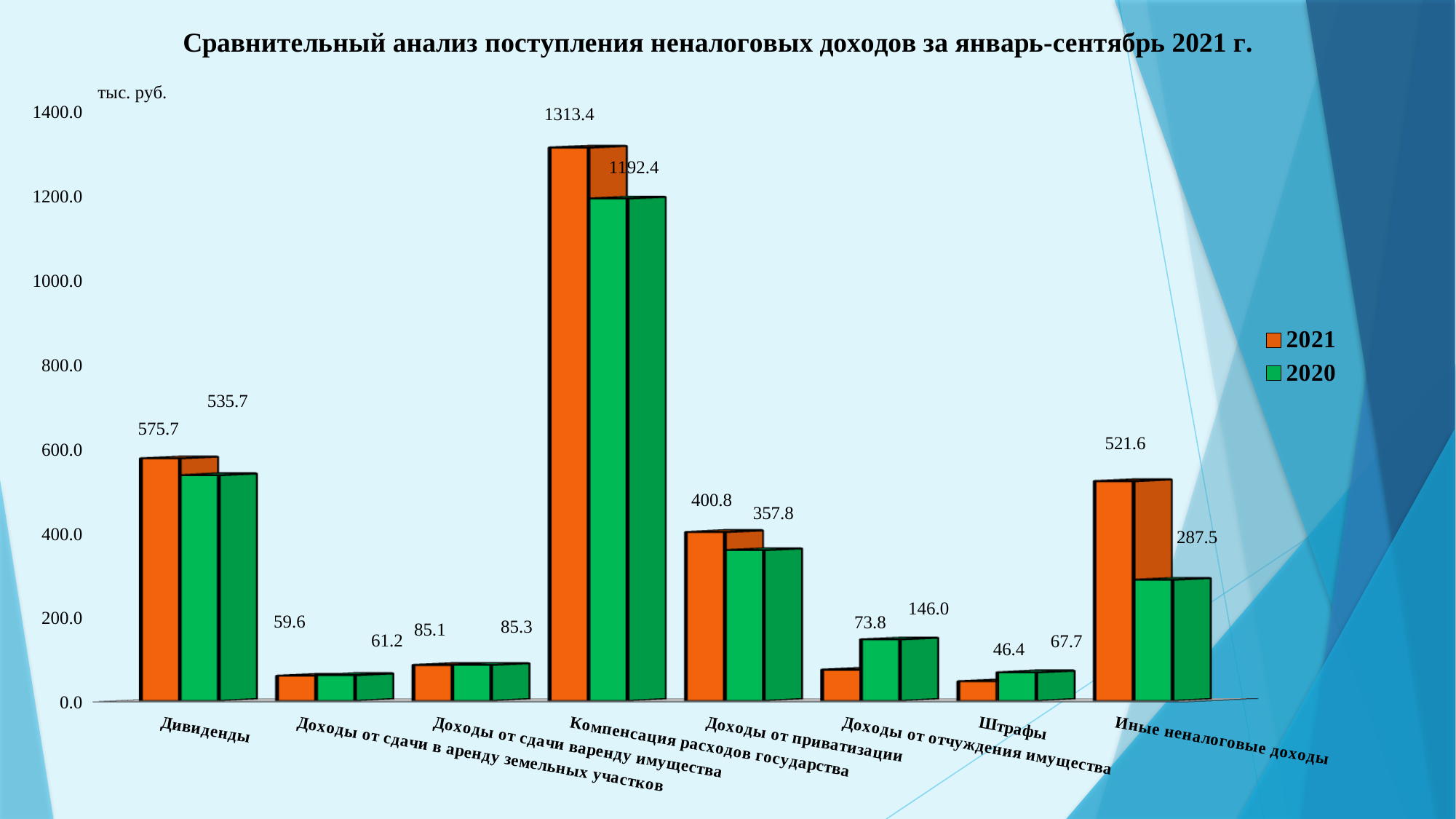
What is the 2021 value for Дивиденды? 575.7 What unit is shown at the top of the vertical axis? тыс. руб. What is the 2020 value for Иные неналоговые доходы? 287.5 What is the 2020 value for Компенсация расходов государства? 1192.4 What is the difference between the 2021 and 2020 values for Иные неналоговые доходы? 234.1 Which category has the highest 2021 value? Компенсация расходов государства For Доходы от отчуждения имущества, which year has the larger value, 2021 or 2020? 2020 What kind of chart is shown on the slide? Bar chart How many categories are shown on the x axis? 8 Which category has the lowest 2021 value? Штрафы How many series does the legend list? 2 What is the 2021 value for Штрафы? 46.4